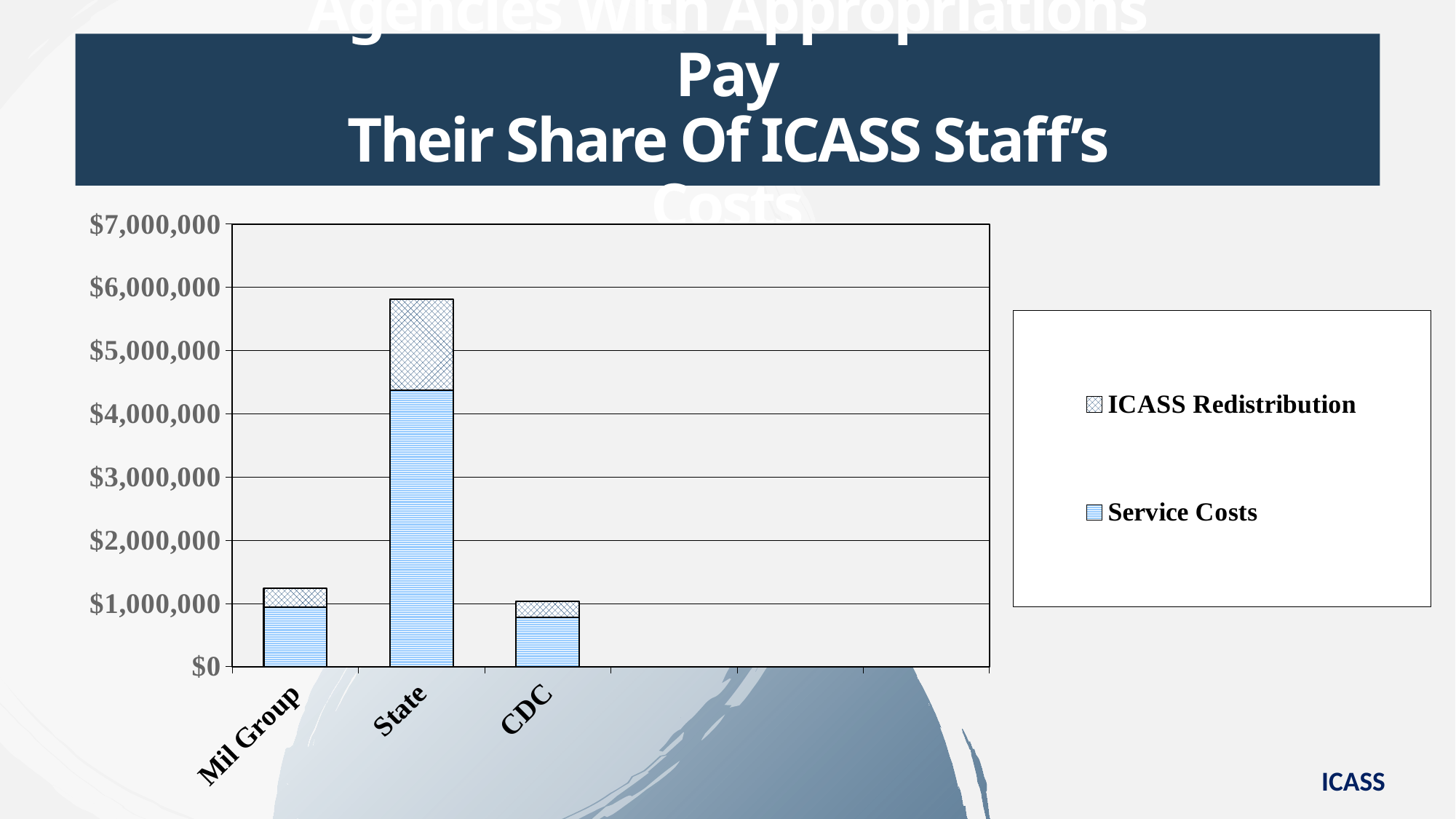
What is the highest value labelled on the y axis of the chart? $7,000,000 Which category has the tallest stacked bar? State How many series does the chart's legend list? 2 Is the Service Costs value for State greater or less than $4,000,000? greater Which series is shown with the cross-hatched pattern in the legend? ICASS Redistribution Is the total value for Mil Group greater or less than $1,000,000? greater Which category has the shortest stacked bar? CDC How many categories are shown on the x axis of the chart? 3 Is the Service Costs value for CDC greater or less than $1,000,000? less What kind of chart is shown on the slide? stacked bar chart Which has the larger total bar, Mil Group or CDC? Mil Group